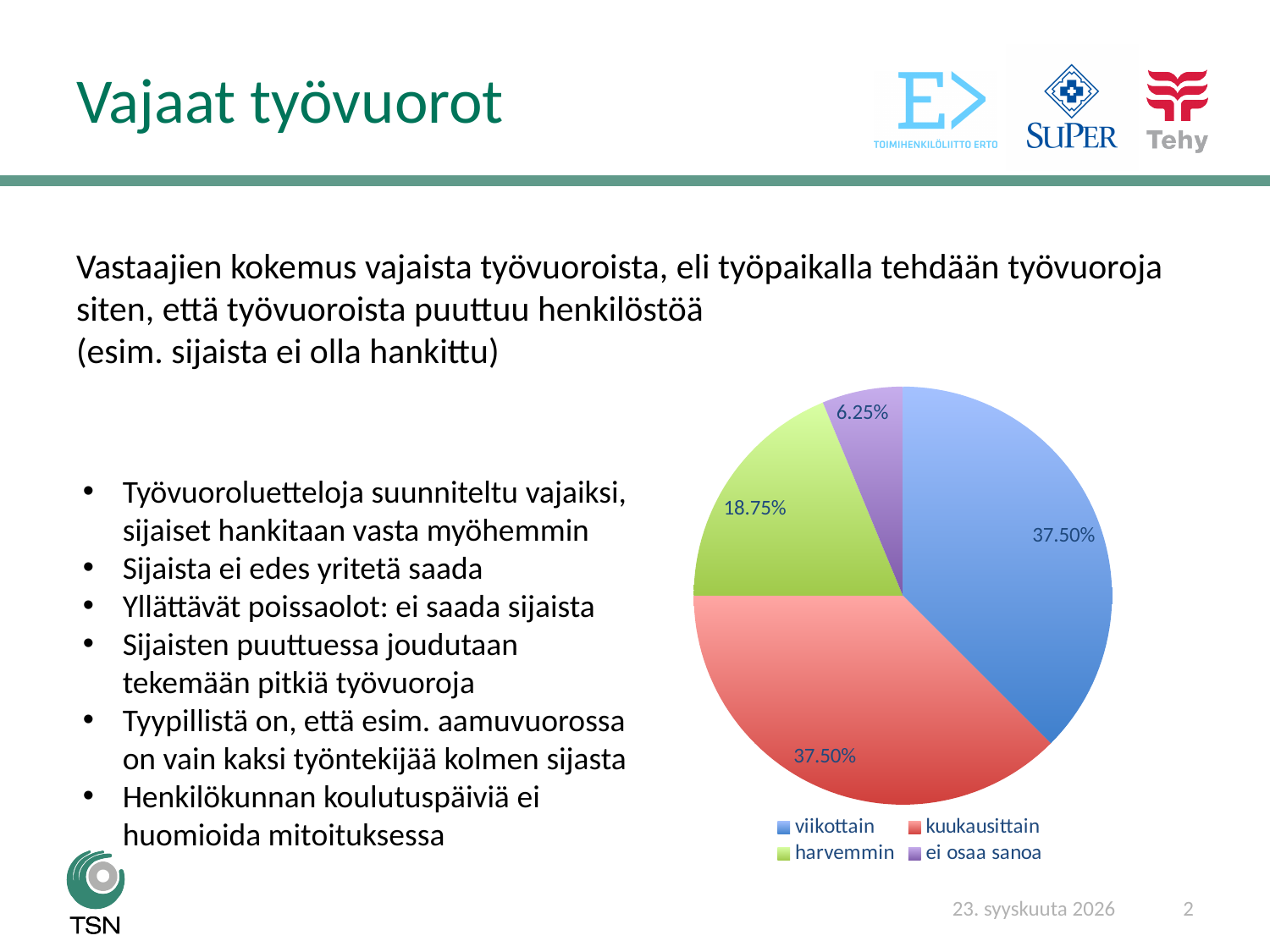
What share of the pie does "harvemmin" have? 18.75% Which category has the smallest slice of the pie? ei osaa sanoa What share of the pie does "ei osaa sanoa" have? 6.25% What colour is the "harvemmin" slice in the pie chart? green Which is larger, the share of "harvemmin" or the share of "ei osaa sanoa"? harvemmin What is the combined share of "viikottain" and "kuukausittain"? 75.00% How many slices does the pie chart have? 4 What kind of chart is shown on the slide? pie chart How many entries does the legend list? 4 What is the difference between the shares of "harvemmin" and "ei osaa sanoa"? 12.50% What share of the pie does "kuukausittain" have? 37.50% What share of the pie does "viikottain" have? 37.50%